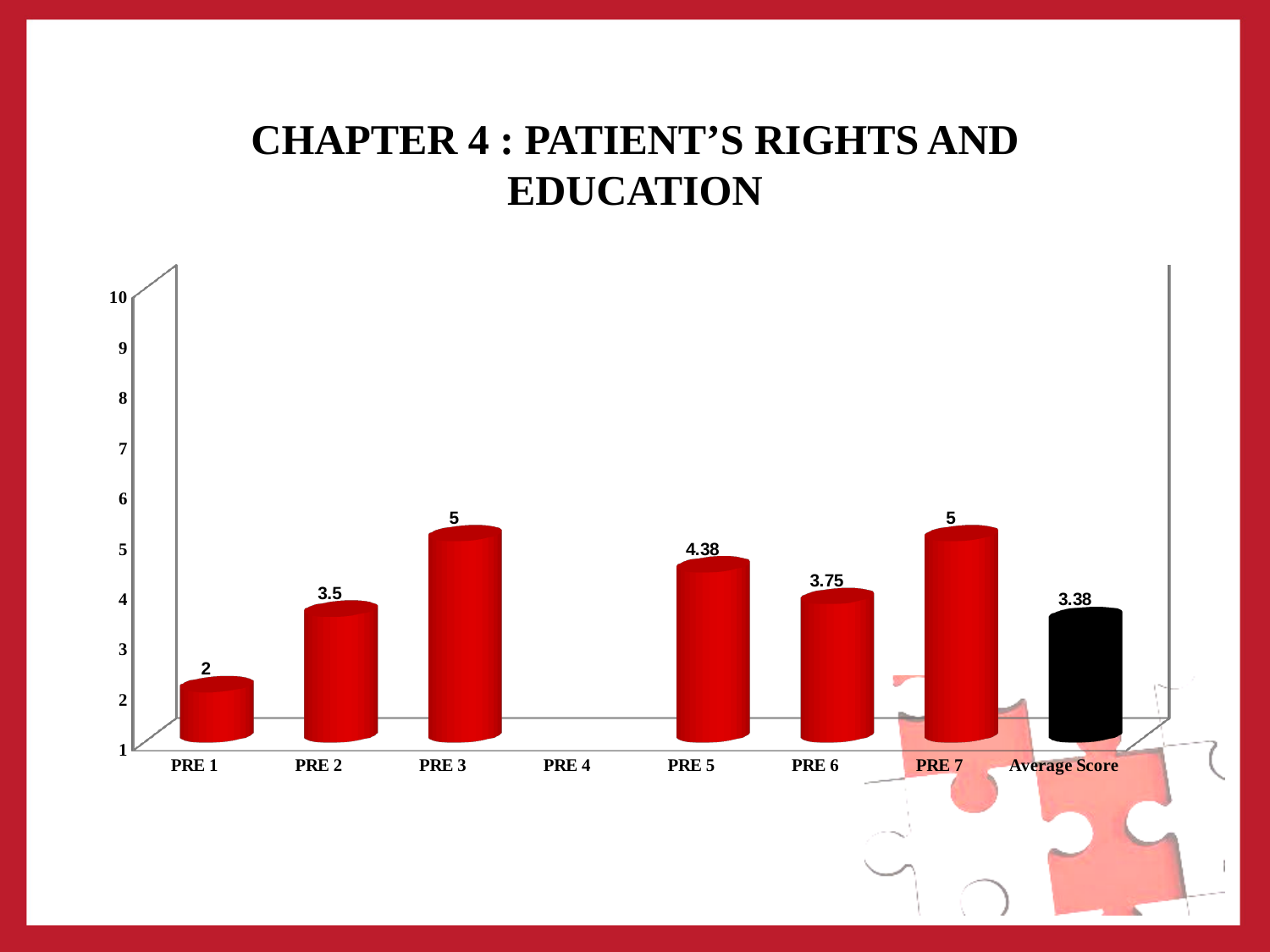
How many categories are labelled on the x axis? 8 What colour is the Average Score bar? Black What is the highest value shown on any bar? 5 What is the value for PRE 1? 2 What is the value for PRE 5? 4.38 Which category has the shortest bar? PRE 1 What is the difference between the values for PRE 3 and PRE 1? 3 What is the value shown for Average Score? 3.38 Is the value for PRE 2 greater or less than 4? less Which is larger, the value for PRE 2 or the value for PRE 6? PRE 6 What is the value for PRE 6? 3.75 What is the difference between the values for PRE 5 and PRE 6? 0.63